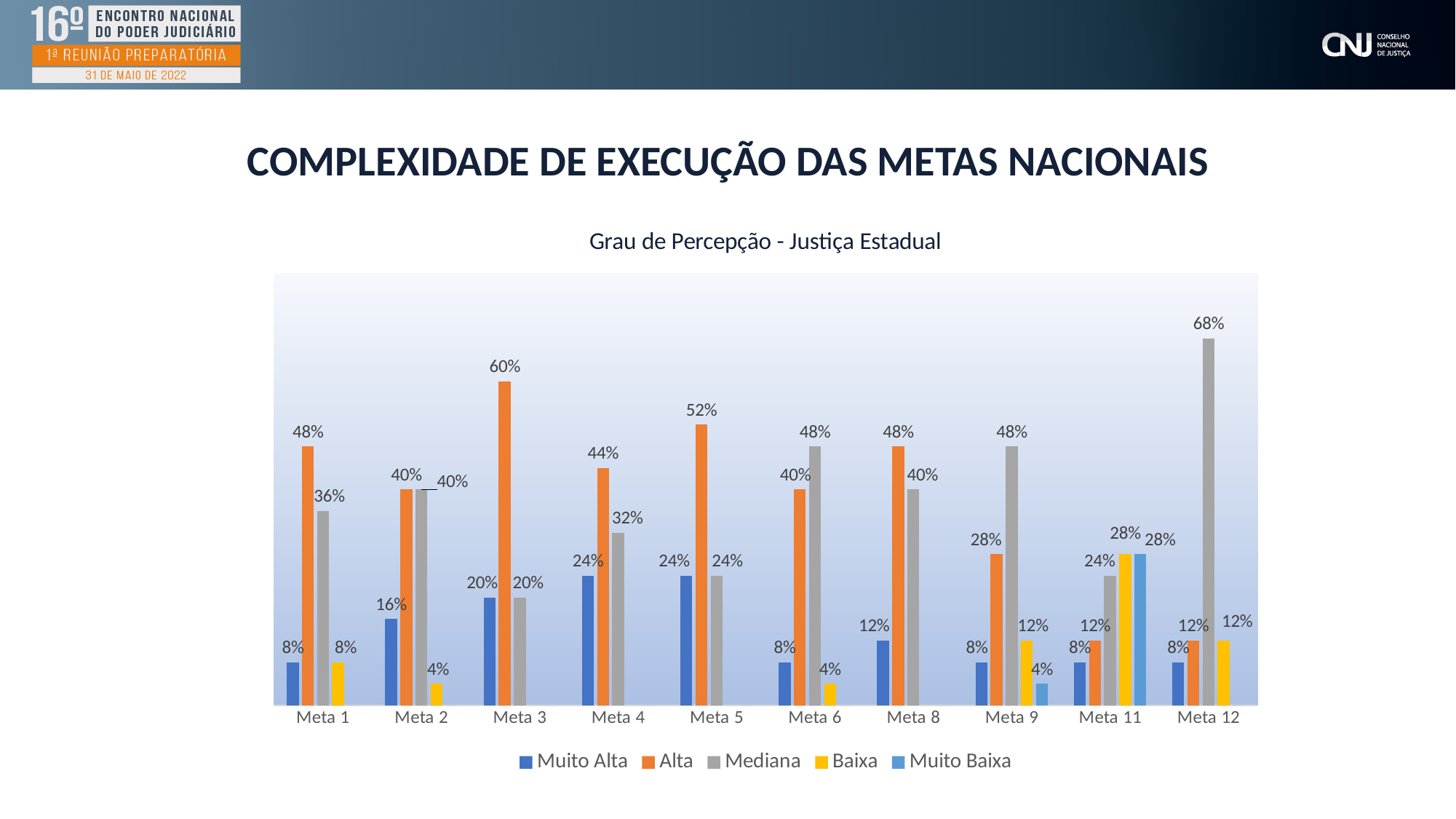
How many categories (Metas) are shown on the x axis? 10 What kind of chart is shown on the slide? Bar chart How many series does the legend list? 5 What is the difference between the Alta value and the Mediana value for Meta 1? 12% For Meta 6, which is larger: the Alta value or the Mediana value? Mediana What is the value of the Muito Baixa series for Meta 9? 4% Which category has the highest Alta value? Meta 3 What is the value of the Alta series for Meta 3? 60% Which category has the highest Mediana value? Meta 12 What is the value of the Mediana series for Meta 12? 68% What is the title of the chart? Grau de Percepção - Justiça Estadual What is the value of the Baixa series for Meta 11? 28%